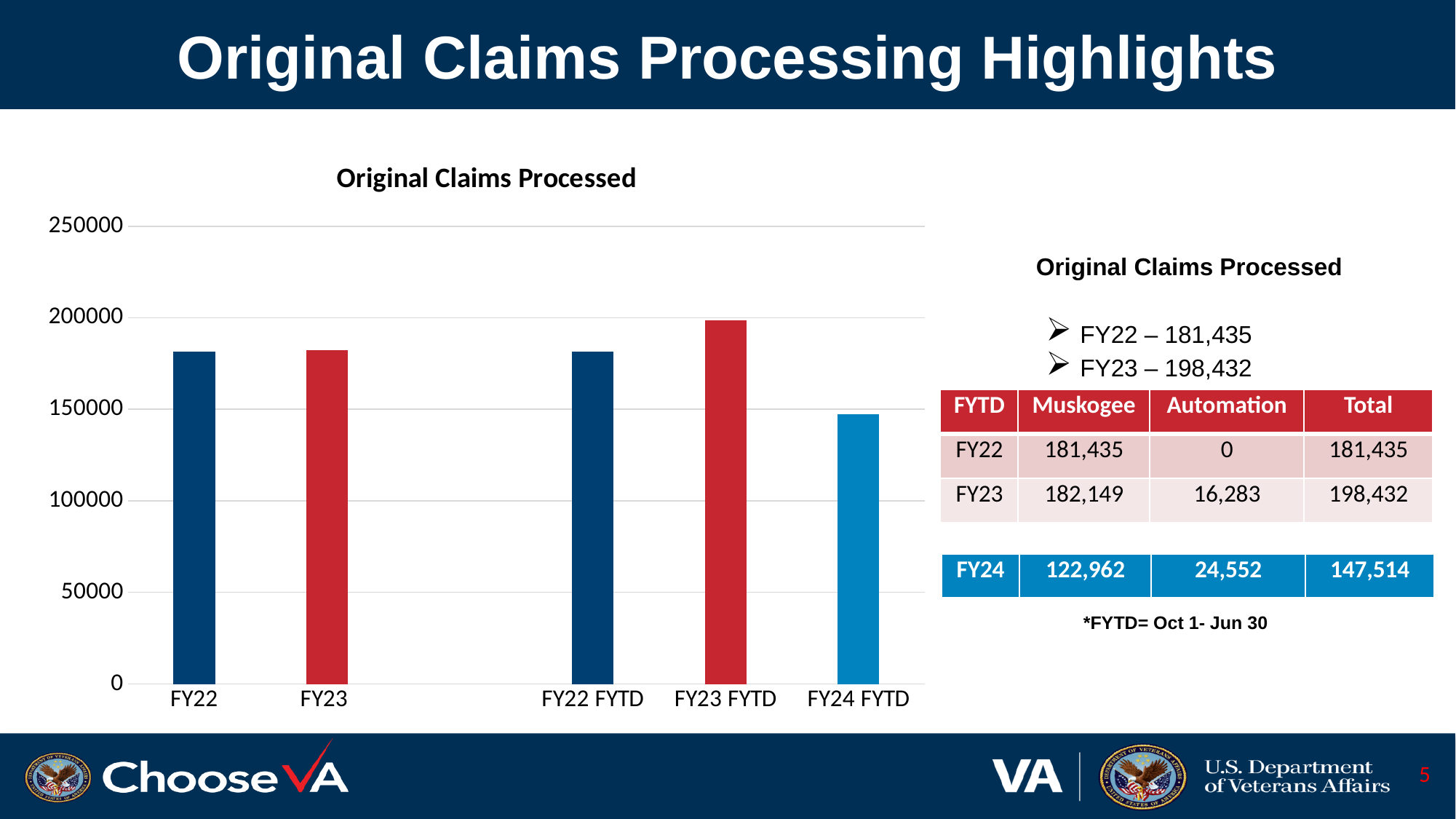
Is the value for FY22 in the chart greater or less than 150000? greater How many bars are plotted in the chart? 5 Is the value for FY24 FYTD in the chart greater or less than 100000? greater Does the value rise or fall from FY23 FYTD to FY24 FYTD in the chart? fall Is the value for FY22 FYTD in the chart greater or less than 200000? less Which is larger in the chart, the bar for FY23 FYTD or the bar for FY24 FYTD? FY23 FYTD What kind of chart is shown on the slide? bar chart What colour is the FY24 FYTD bar in the chart? light blue What is the title of the chart? Original Claims Processed Which category has the lowest bar in the chart? FY24 FYTD